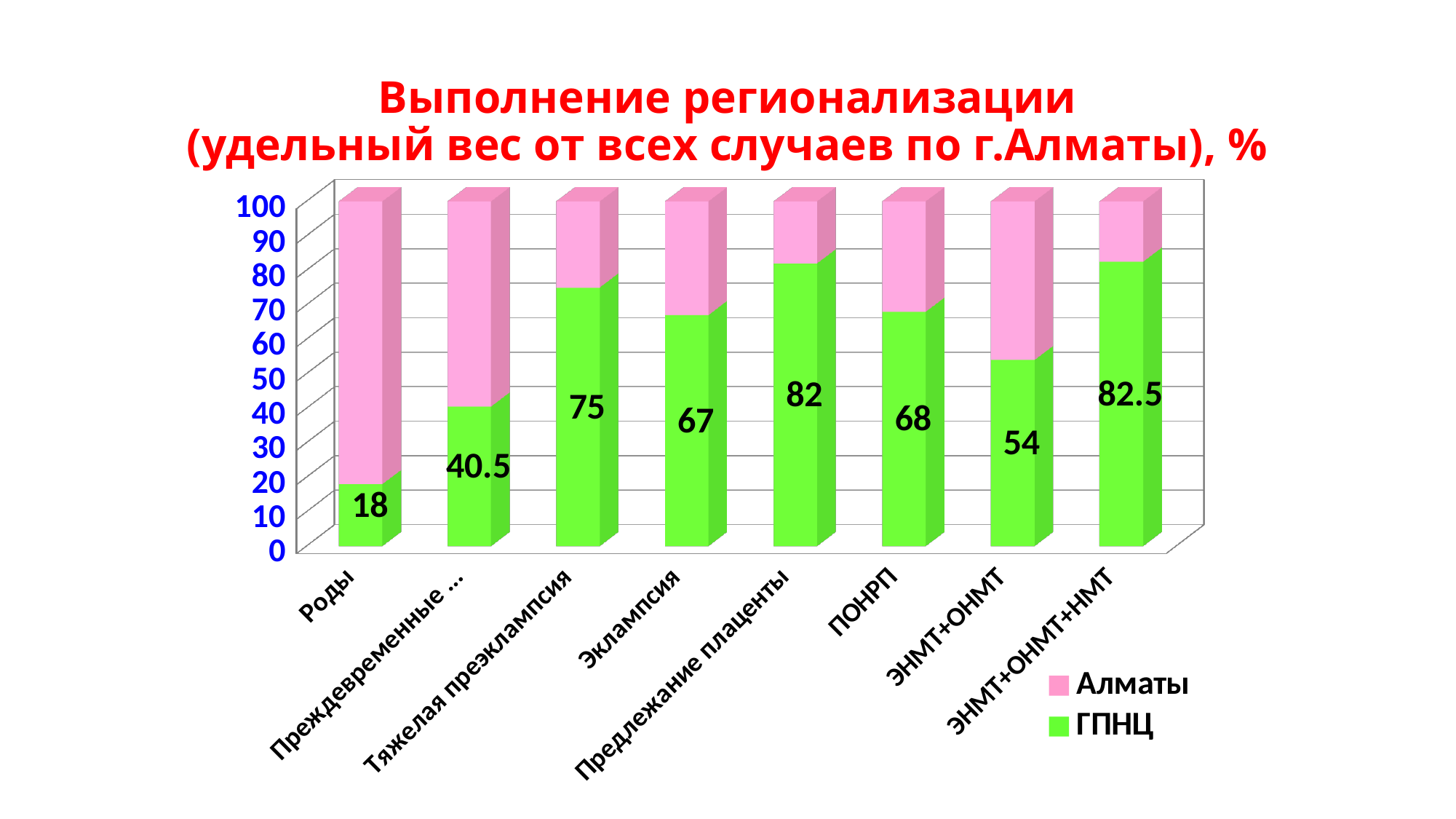
What is the ГПНЦ value for ЭНМТ+ОНМТ+НМТ? 82.5 Which category has the lowest ГПНЦ value? Роды Which category has the highest ГПНЦ value? ЭНМТ+ОНМТ+НМТ How many categories are shown on the x axis? 8 Is the ГПНЦ value for ЭНМТ+ОНМТ greater or less than 60? less What is the ГПНЦ value for Роды? 18 What kind of chart is shown on the slide? stacked bar chart How many series does the legend list? 2 What is the difference between the ГПНЦ values for Тяжелая преэклампсия and ЭНМТ+ОНМТ? 21 Which has a larger ГПНЦ value, Предлежание плаценты or ПОНРП? Предлежание плаценты What is the ГПНЦ value for Эклампсия? 67 What is the ГПНЦ value for ПОНРП? 68